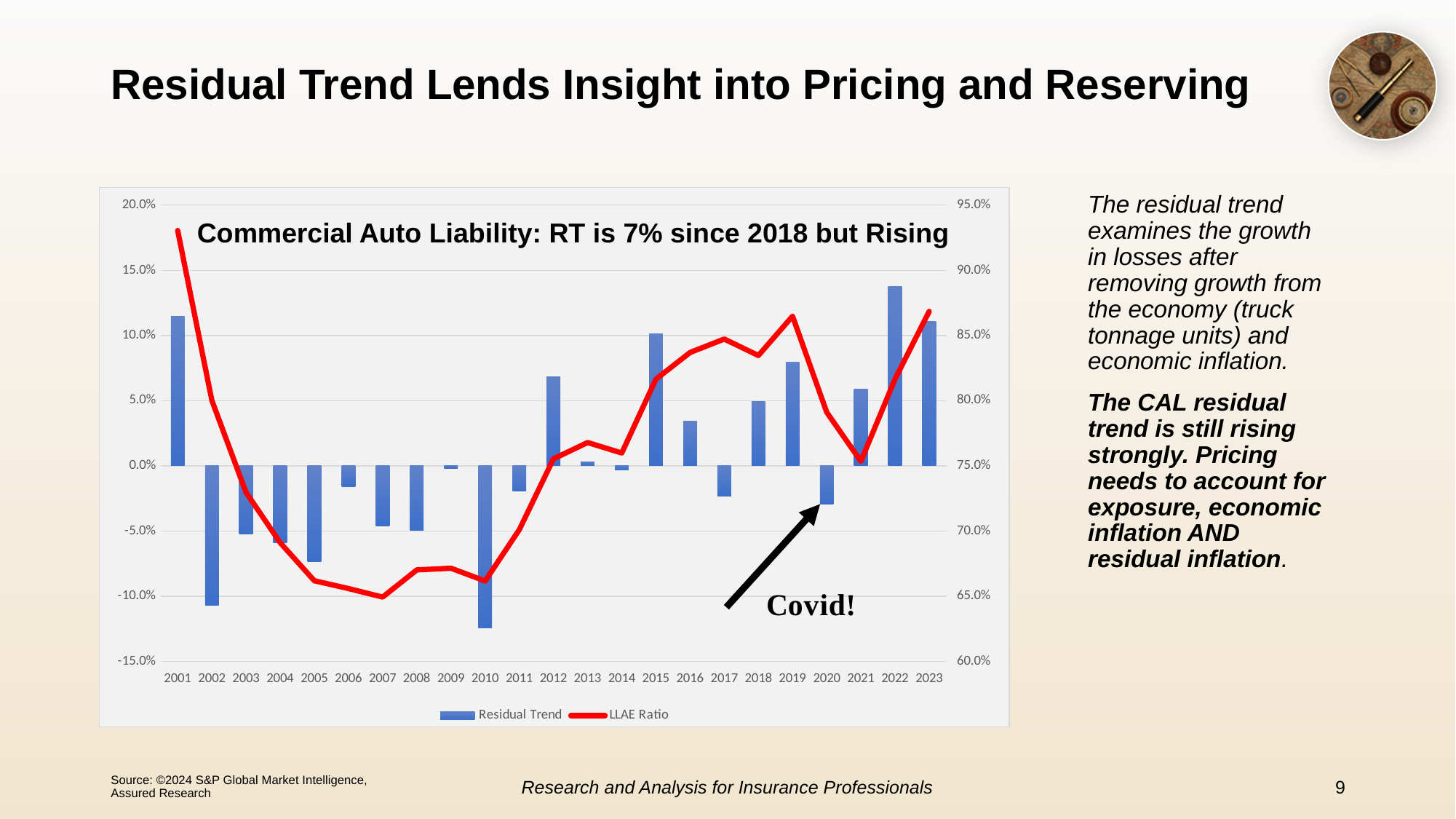
What is the title of the chart on the slide? Commercial Auto Liability: RT is 7% since 2018 but Rising Is the LLAE Ratio for 2007 greater or less than 70.0%? less How many series does the chart's legend list? 2 How many years are shown along the x axis of the chart? 23 Is the Residual Trend value for 2010 greater or less than -10.0%? less Which year has the larger Residual Trend value, 2001 or 2022? 2022 What kind of chart is shown on the slide? A bar chart combined with a line chart Is the Residual Trend value for 2022 greater or less than 10.0%? greater Which year does the 'Covid!' arrow annotation point to? 2020 Which year has the highest LLAE Ratio? 2001 Which year has the highest Residual Trend bar? 2022 Which year has the lowest Residual Trend bar? 2010